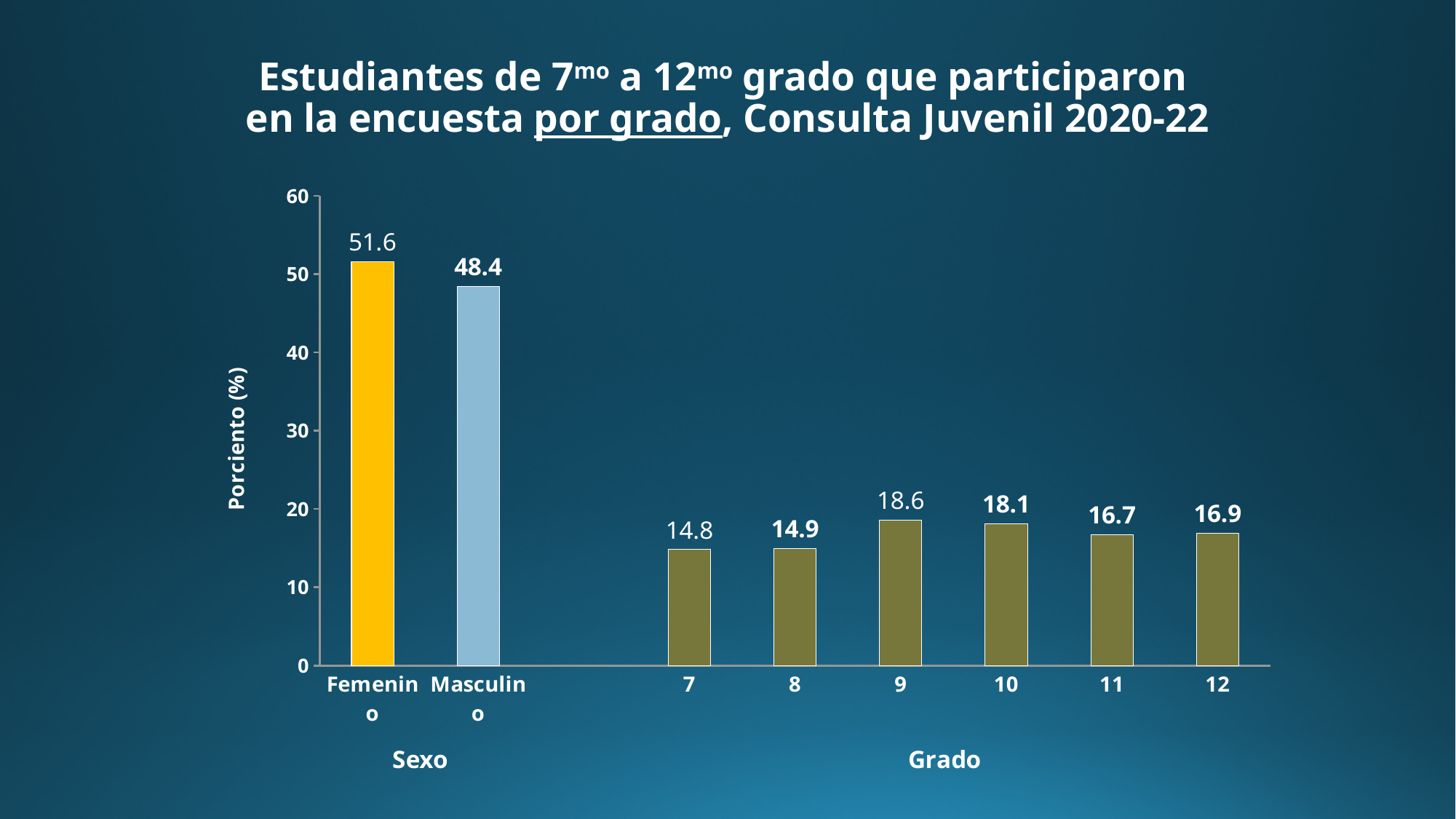
Which grade has the highest value? 9 What is the value for Masculino? 48.4 Is the value for Femenino greater or less than 50? greater What kind of chart is shown on the slide? bar chart What is the difference between the values for Femenino and Masculino? 3.2 What is the difference between the values for grade 9 and grade 7? 3.8 How many grade categories are plotted under Grado? 6 What is the value for grade 11? 16.7 What is the value for Femenino? 51.6 What is the value for grade 9? 18.6 Which is larger, the value for grade 10 or the value for grade 12? grade 10 Which grade has the lowest value? 7